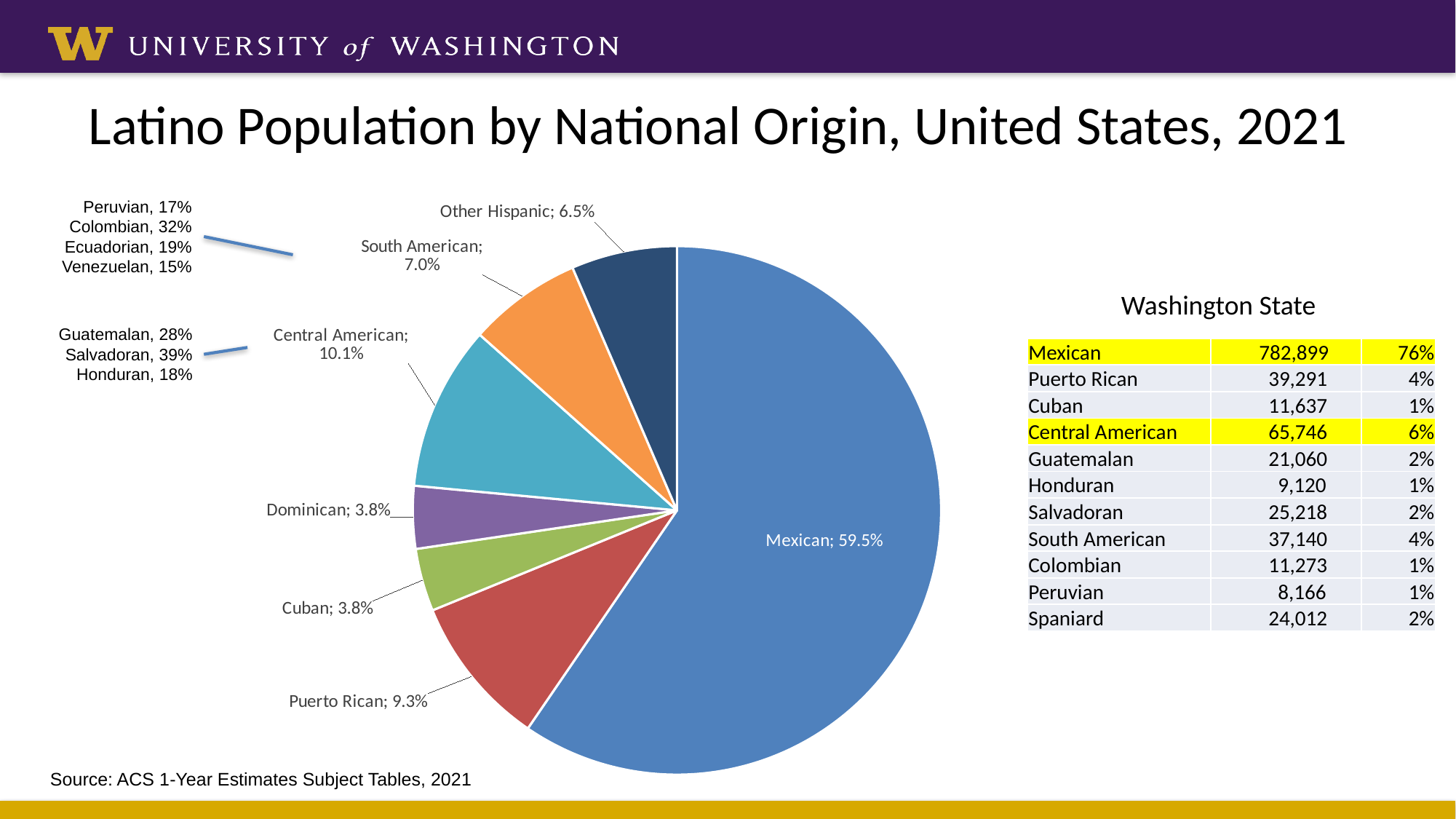
What is the title of the slide containing the pie chart? Latino Population by National Origin, United States, 2021 What is the difference in percentage points between the Central American and Puerto Rican slices? 0.8 What is the value shown for Central American in the pie chart? 10.1% How many slices does the pie chart have? 7 What type of chart is shown on the slide? pie chart What share of the pie does the Mexican slice represent? 59.5% Which category has the largest slice in the pie chart? Mexican Which slice is larger, South American or Other Hispanic? South American What is the value shown for Cuban in the pie chart? 3.8% What is the value shown for Puerto Rican in the pie chart? 9.3% What is the value shown for South American in the pie chart? 7.0% What is the value shown for Other Hispanic in the pie chart? 6.5%